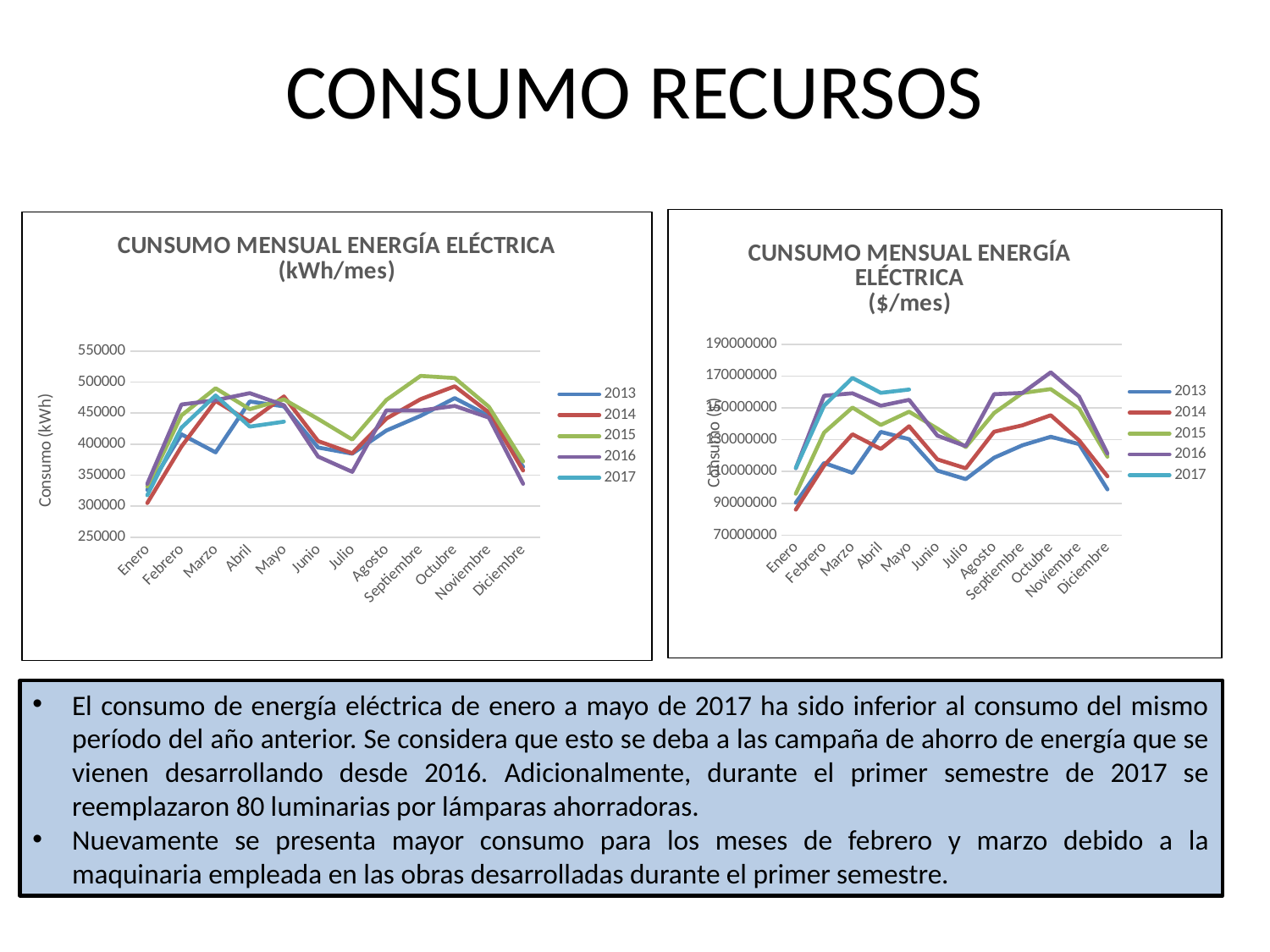
How many months are shown on the x axis of the left chart (kWh/mes)? 12 In the left chart (kWh/mes), is the value for 2015 in Septiembre greater or less than 500000? greater How many series does the legend of the right chart ("$/mes") list? 5 In the right chart ($/mes), is the value for 2013 in Julio greater or less than 130000000? less In the left chart (kWh/mes), does the 2014 line rise or fall from Octubre to Diciembre? Fall In the right chart ($/mes), is the value for 2016 in Octubre greater or less than 150000000? greater Which series in the left chart (kWh/mes) is plotted only from Enero to Mayo? 2017 What is the y-axis label of the left chart (kWh/mes)? Consumo (kWh) What kind of chart is the left chart titled 'CUNSUMO MENSUAL ENERGÍA ELÉCTRICA (kWh/mes)'? Line chart